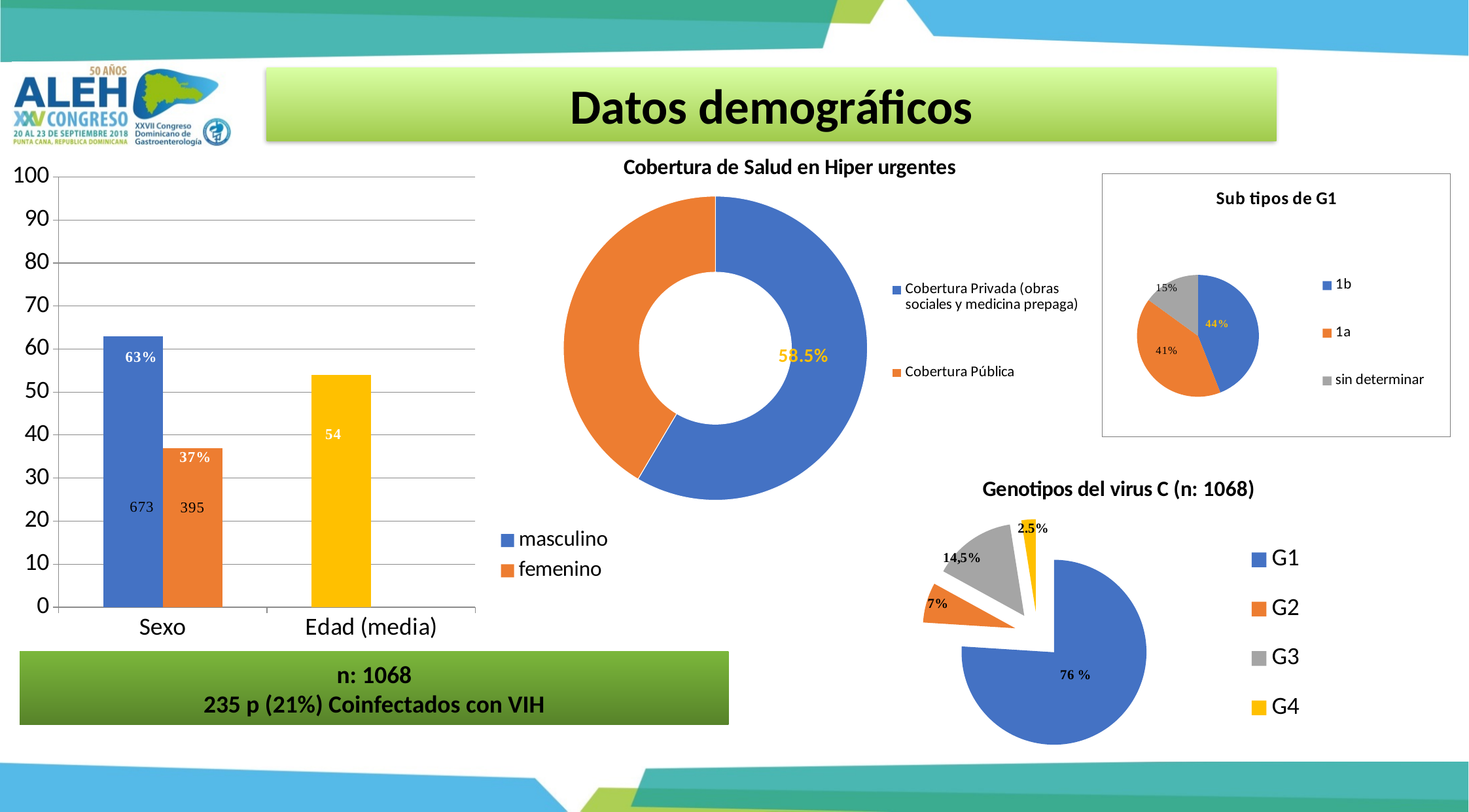
In the chart titled 'Genotipos del virus C (n: 1068)', how many categories does the legend list? 4 In the chart titled 'Cobertura de Salud en Hiper urgentes', what share is shown for Cobertura Privada (obras sociales y medicina prepaga)? 58.5% In the chart titled 'Sub tipos de G1', which category has the smallest share? sin determinar In the chart titled 'Sub tipos de G1', what share is shown for 1a? 41% In the chart titled 'Genotipos del virus C (n: 1068)', what share is shown for G3? 14,5% In the chart titled 'Genotipos del virus C (n: 1068)', which genotype has the largest share? G1 In the bar chart on the left, what is the difference between the masculino and femenino percentages? 26% In the bar chart on the left, how many series does the legend list? 2 In the chart titled 'Cobertura de Salud en Hiper urgentes', which category has the larger share, Cobertura Privada or Cobertura Pública? Cobertura Privada In the bar chart on the left, what is the value shown for femenino under Sexo? 37% In the bar chart on the left, what is the value shown for masculino under Sexo? 63% In the bar chart on the left, what is the value shown for Edad (media)? 54